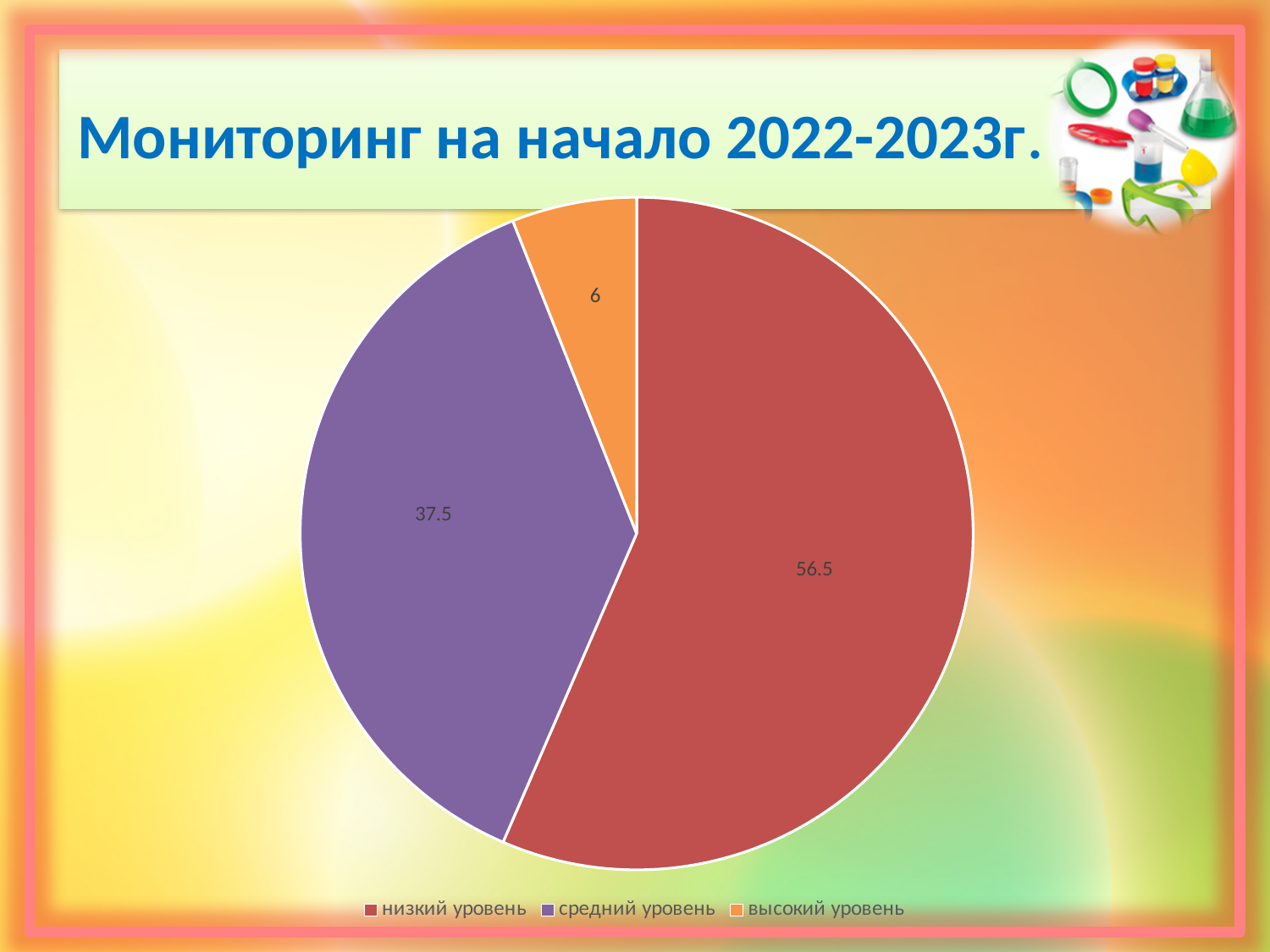
Which category has the largest slice? низкий уровень What is the value for высокий уровень? 6 How many entries does the legend list? 3 What is the value for средний уровень? 37.5 What is the difference between the values for низкий уровень and средний уровень? 19 How many slices does the pie chart have? 3 What kind of chart is shown on the slide? pie chart What is the value for низкий уровень? 56.5 What colour is the slice for средний уровень? purple Which category has the smallest slice? высокий уровень What is the difference between the values for средний уровень and высокий уровень? 31.5 Which is larger, the value for средний уровень or the value for высокий уровень? средний уровень